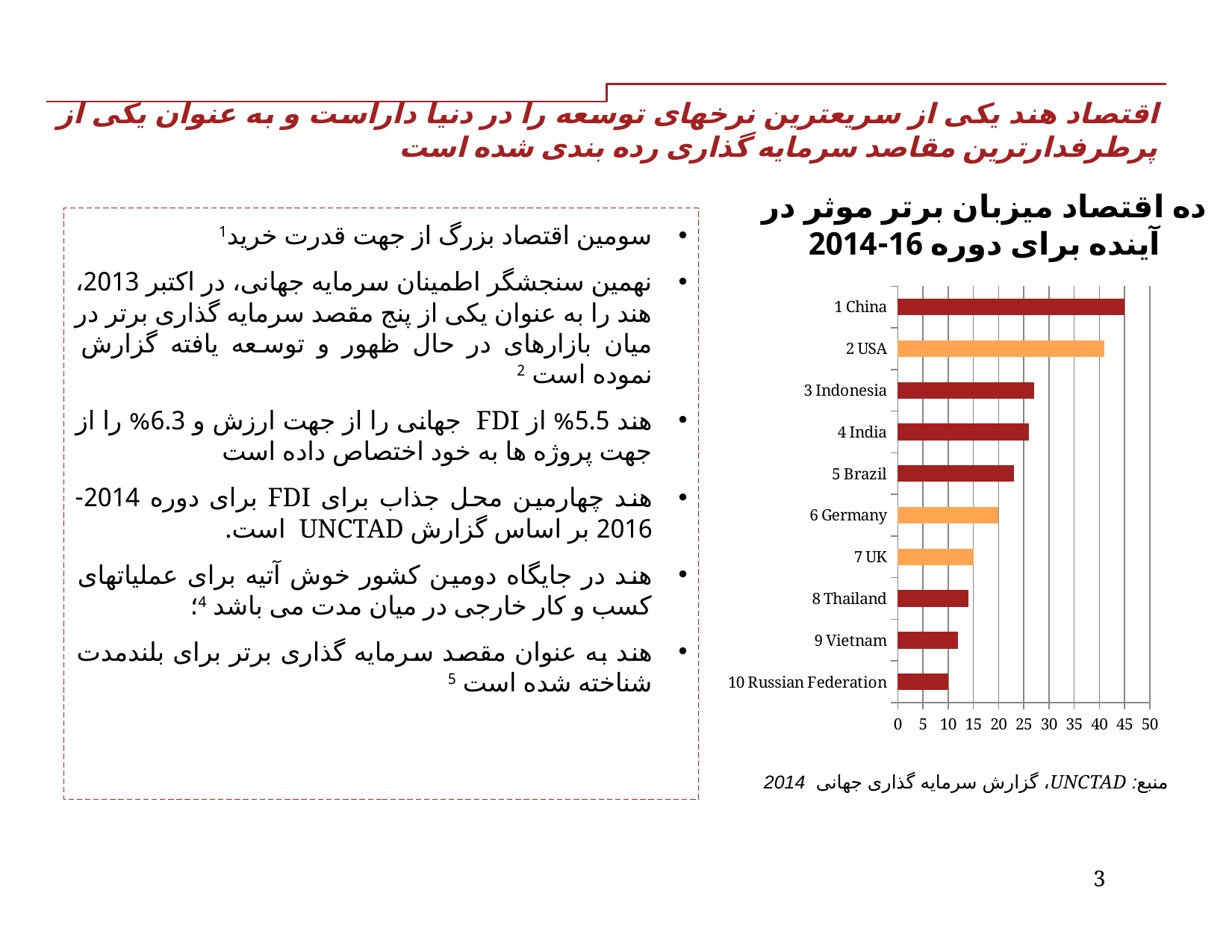
Which country has the highest value in the chart? China What kind of chart is shown on the slide? bar chart Is the value for UK greater or less than 20? less Which has the larger value, China or USA? China Which countries' bars are coloured orange rather than dark red? USA, Germany, UK Is the value for India greater or less than 30? less Is the value for China greater or less than 40? greater Which country has the lowest value in the chart? Russian Federation How many countries are shown in the bar chart? 10 Which has the larger value, Brazil or Germany? Brazil